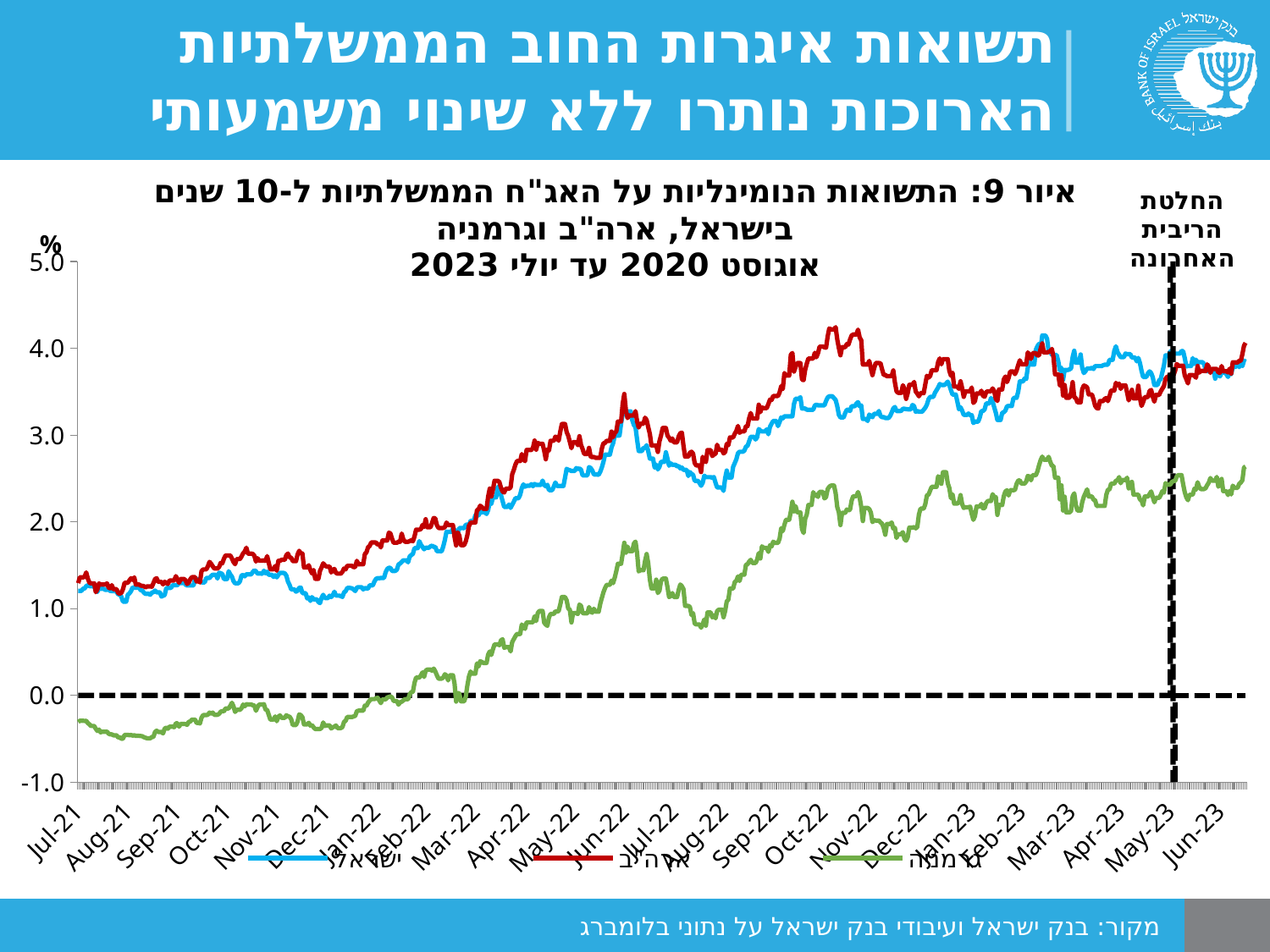
What kind of chart is shown on the slide? line chart Is the value for גרמניה at Jun-23 greater or less than 2.0? greater Which series is plotted in green in the chart? גרמניה Is the value for ישראל at Jul-21 greater or less than 1.0? greater How many series does the legend of the chart list? 3 What unit is shown on the y axis of the chart? % At Jul-21, which is larger: the value for ישראל or the value for גרמניה? ישראל Is the value for ארה"ב at Jul-21 greater or less than 2.0? less Which series has the lowest value at Jun-23? גרמניה Does the value for גרמניה rise or fall overall from Jul-21 to Jun-23? rise